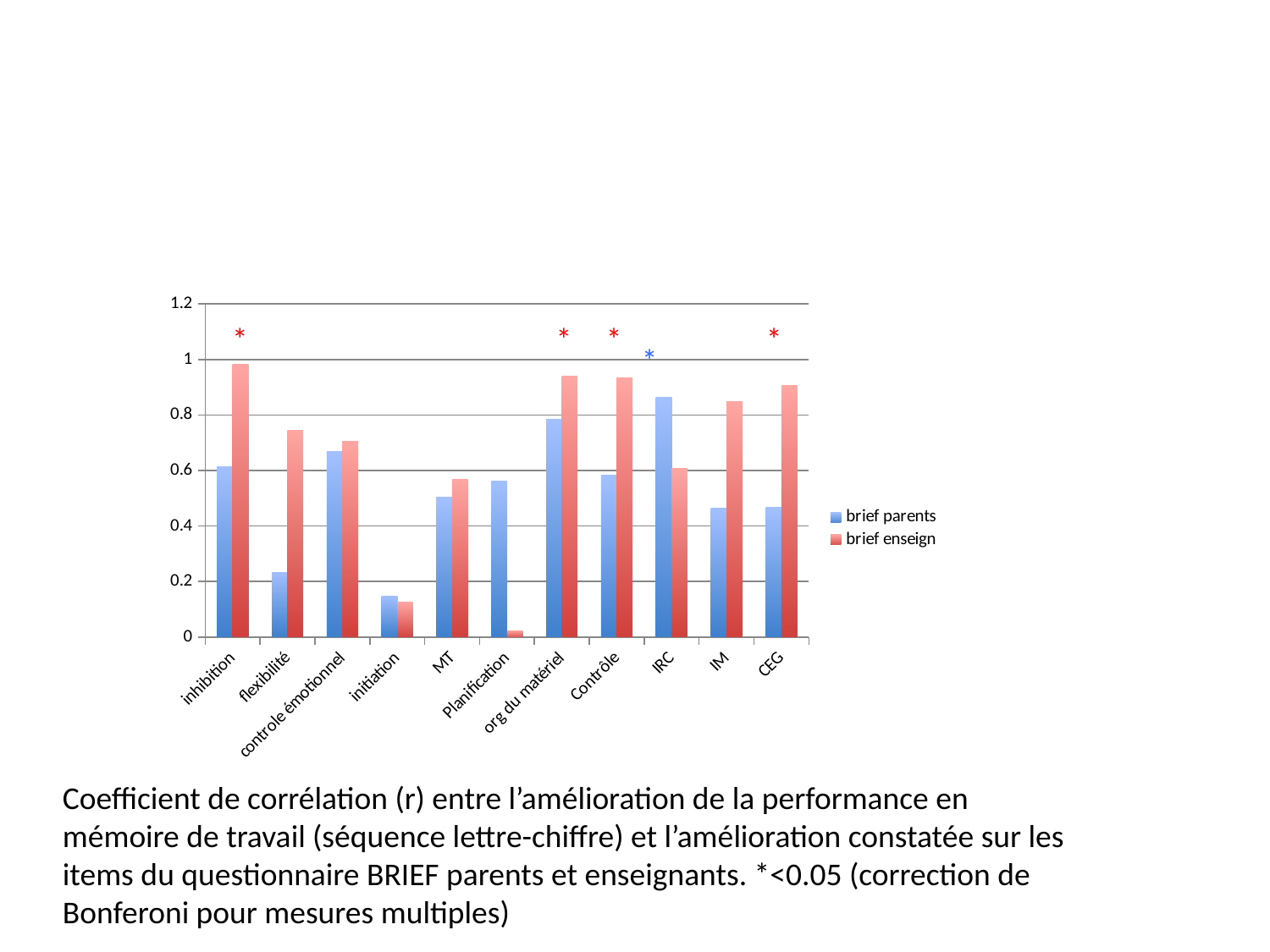
Is the brief enseign value for IM greater or less than 0.8? greater What kind of chart is shown on the slide? bar chart Is the brief parents value for flexibilité greater or less than 0.4? less How many categories are shown on the x axis? 11 Which category has the highest value for the brief parents series? IRC For IRC, which series has the larger value, brief parents or brief enseign? brief parents Which category has the lowest value for the brief enseign series? Planification How many series does the legend list? 2 Which category has the lowest value for the brief parents series? initiation For inhibition, which series has the larger value, brief parents or brief enseign? brief enseign Is the brief enseign value for inhibition greater or less than 0.8? greater What are the two series names listed in the legend? brief parents, brief enseign